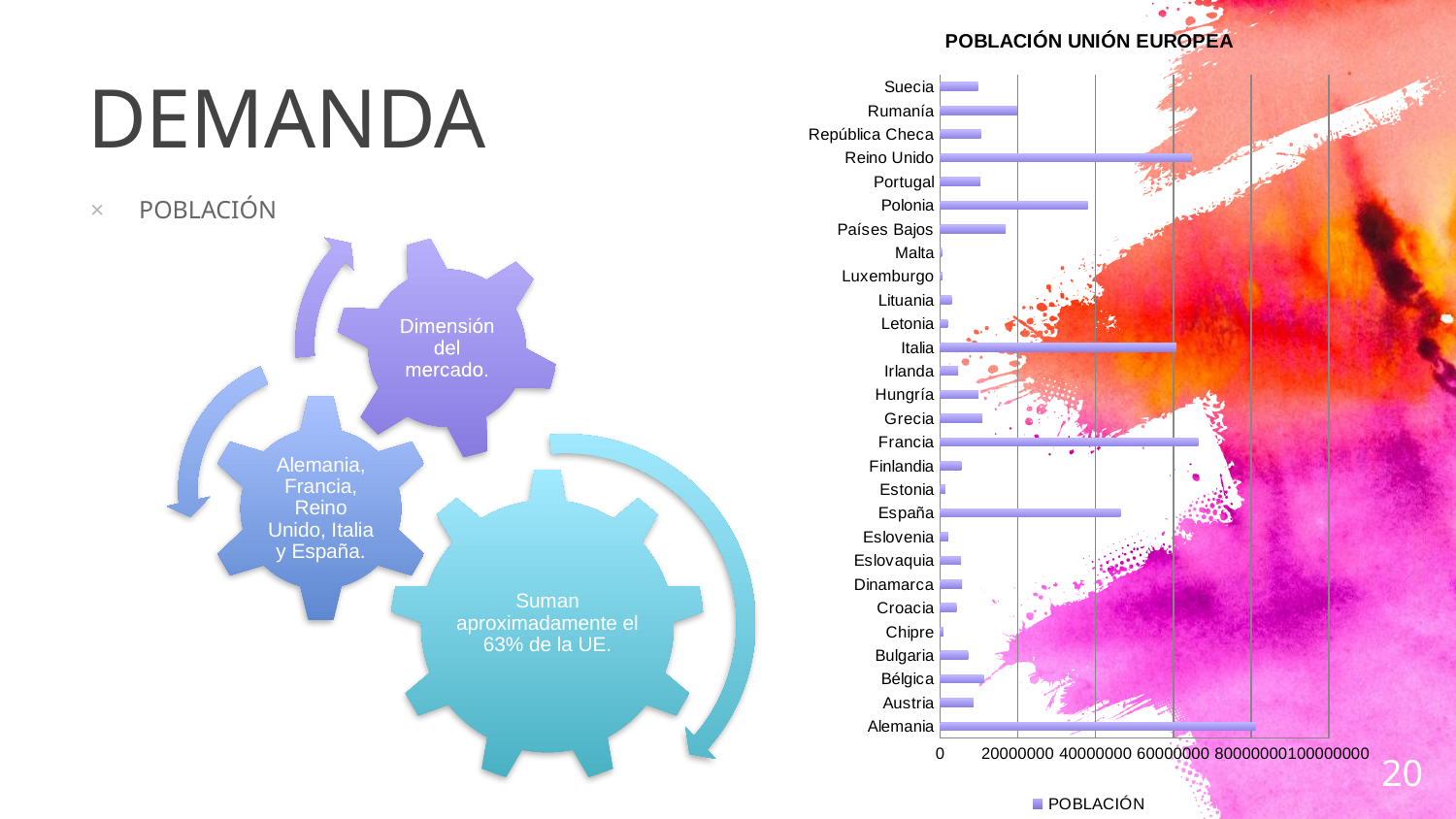
Is the value for Alemania greater or less than 60000000? greater What is the title of the chart? POBLACIÓN UNIÓN EUROPEA Which country has the highest population on the chart? Alemania Which has a larger population, Polonia or Rumanía? Polonia What is the name of the series shown in the legend? POBLACIÓN Which has a larger population, Francia or España? Francia Is the value for España greater or less than 40000000? greater What kind of chart is shown on the slide? bar chart How many countries are listed on the chart? 28 Is the value for Países Bajos greater or less than 20000000? less How many series does the legend list? 1